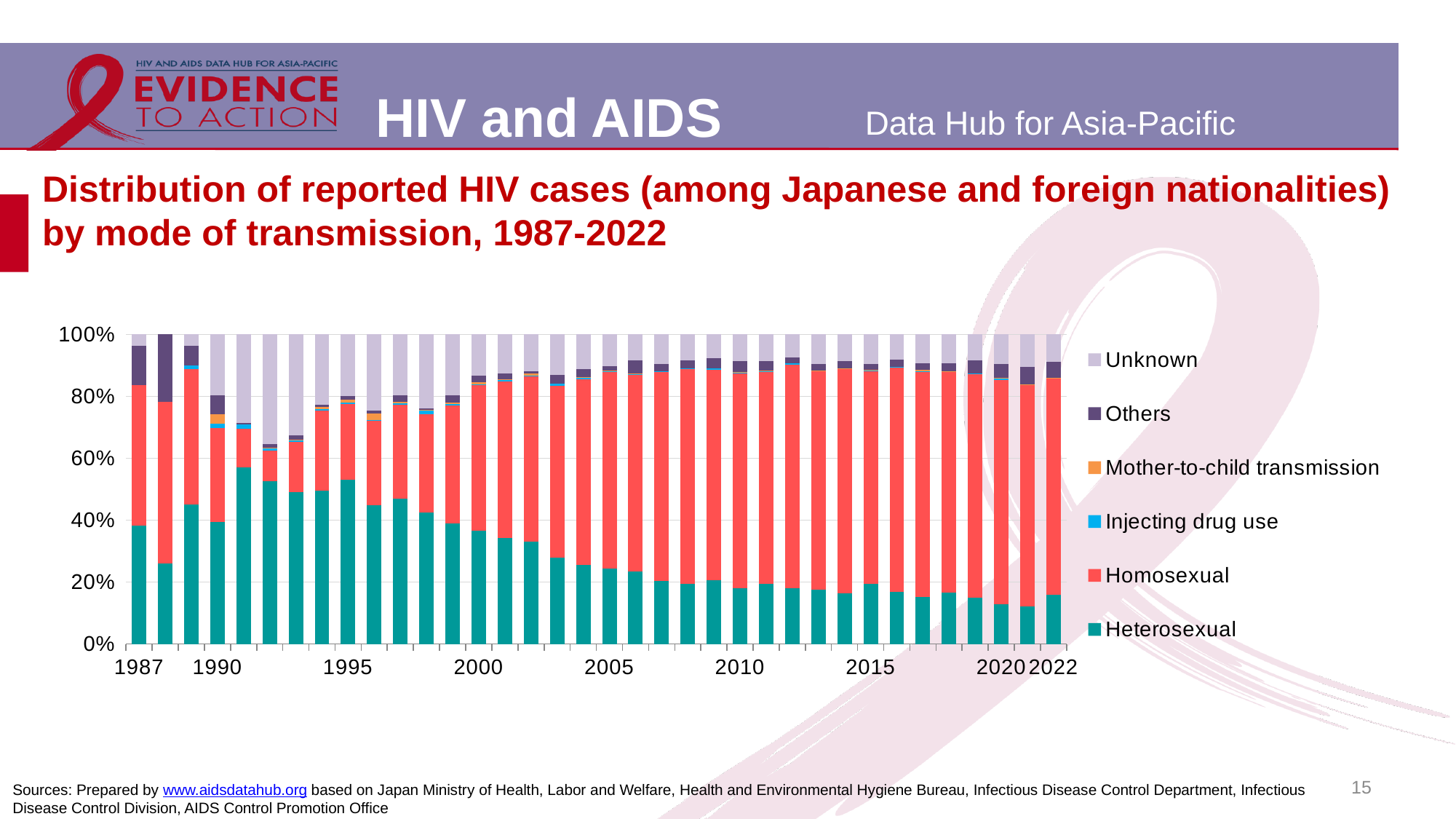
How many series does the legend list? 6 Does the Heterosexual share generally rise or fall from 1995 to 2022? fall Which is larger, the Heterosexual share in 1991 or in 2022? 1991 What kind of chart is shown on the slide? Stacked bar chart Is the Unknown share in 1992 greater or less than 20%? greater Which mode of transmission is shown at the bottom of each stacked bar? Heterosexual Is the Heterosexual share in 2020 greater or less than 20%? less Which year has the highest Heterosexual share? 1991 Is the Heterosexual share in 1987 greater or less than 40%? less What is the title of the chart on the slide? Distribution of reported HIV cases (among Japanese and foreign nationalities) by mode of transmission, 1987-2022 How many years (bars) are plotted in the chart? 36